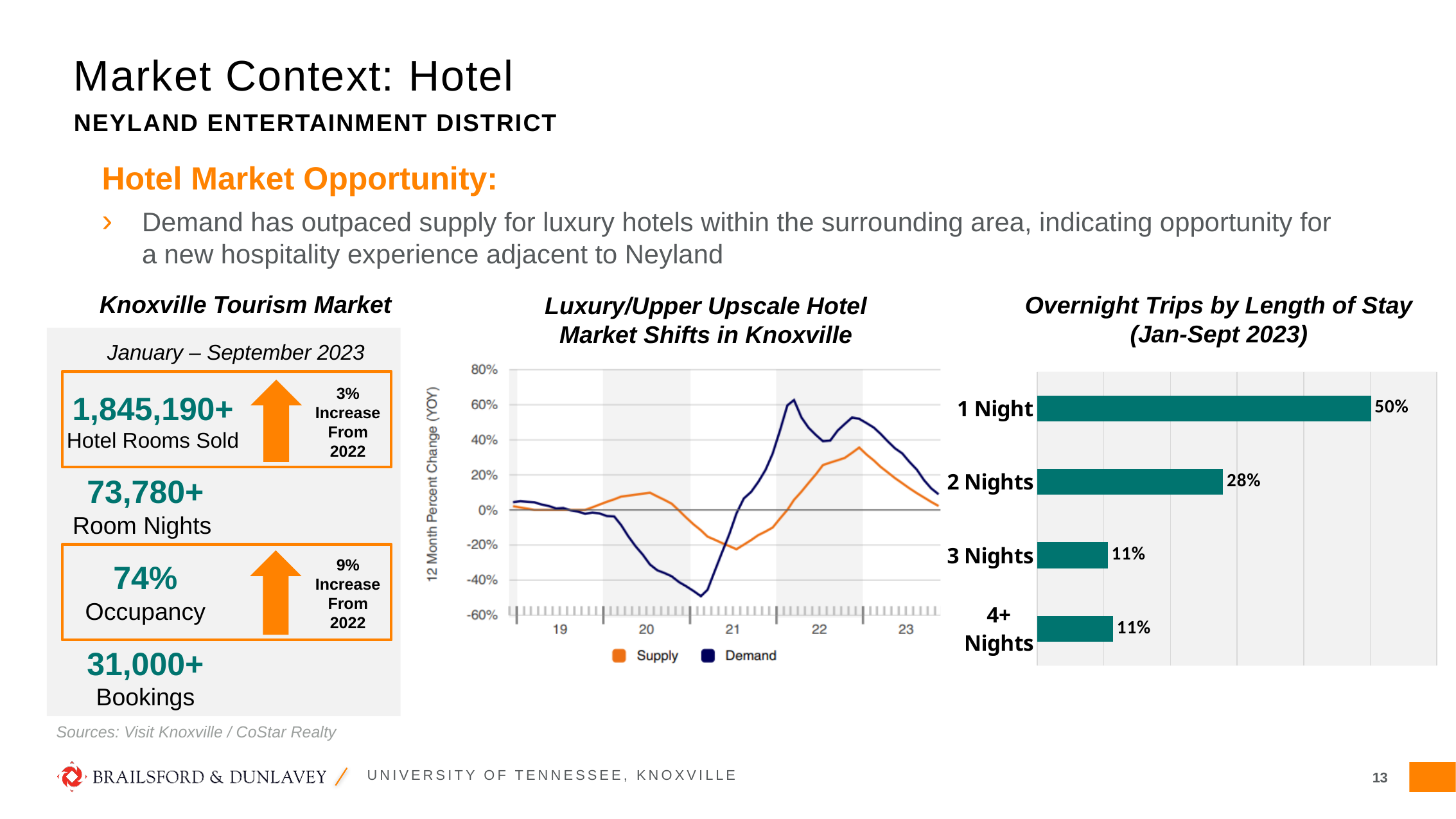
What kind of chart is 'Luxury/Upper Upscale Hotel Market Shifts in Knoxville'? Line chart In the 'Overnight Trips by Length of Stay' chart, what is the difference between the values for 1 Night and 2 Nights? 22% In the 'Overnight Trips by Length of Stay' chart, what is the value for 1 Night? 50% In the 'Overnight Trips by Length of Stay' chart, what is the value for 3 Nights? 11% In the 'Overnight Trips by Length of Stay' chart, what is the value for 2 Nights? 28% In the 'Luxury/Upper Upscale Hotel Market Shifts in Knoxville' chart, which series is drawn in orange? Supply In the 'Overnight Trips by Length of Stay' chart, which length of stay has the highest share? 1 Night What kind of chart is 'Overnight Trips by Length of Stay'? Bar chart How many series does the legend of the 'Luxury/Upper Upscale Hotel Market Shifts in Knoxville' chart list? 2 In the 'Overnight Trips by Length of Stay' chart, which is larger, the value for 2 Nights or the value for 3 Nights? 2 Nights How many categories are shown in the 'Overnight Trips by Length of Stay' chart? 4 In the 'Luxury/Upper Upscale Hotel Market Shifts in Knoxville' chart, is the peak value of the Demand line greater or less than 40%? greater